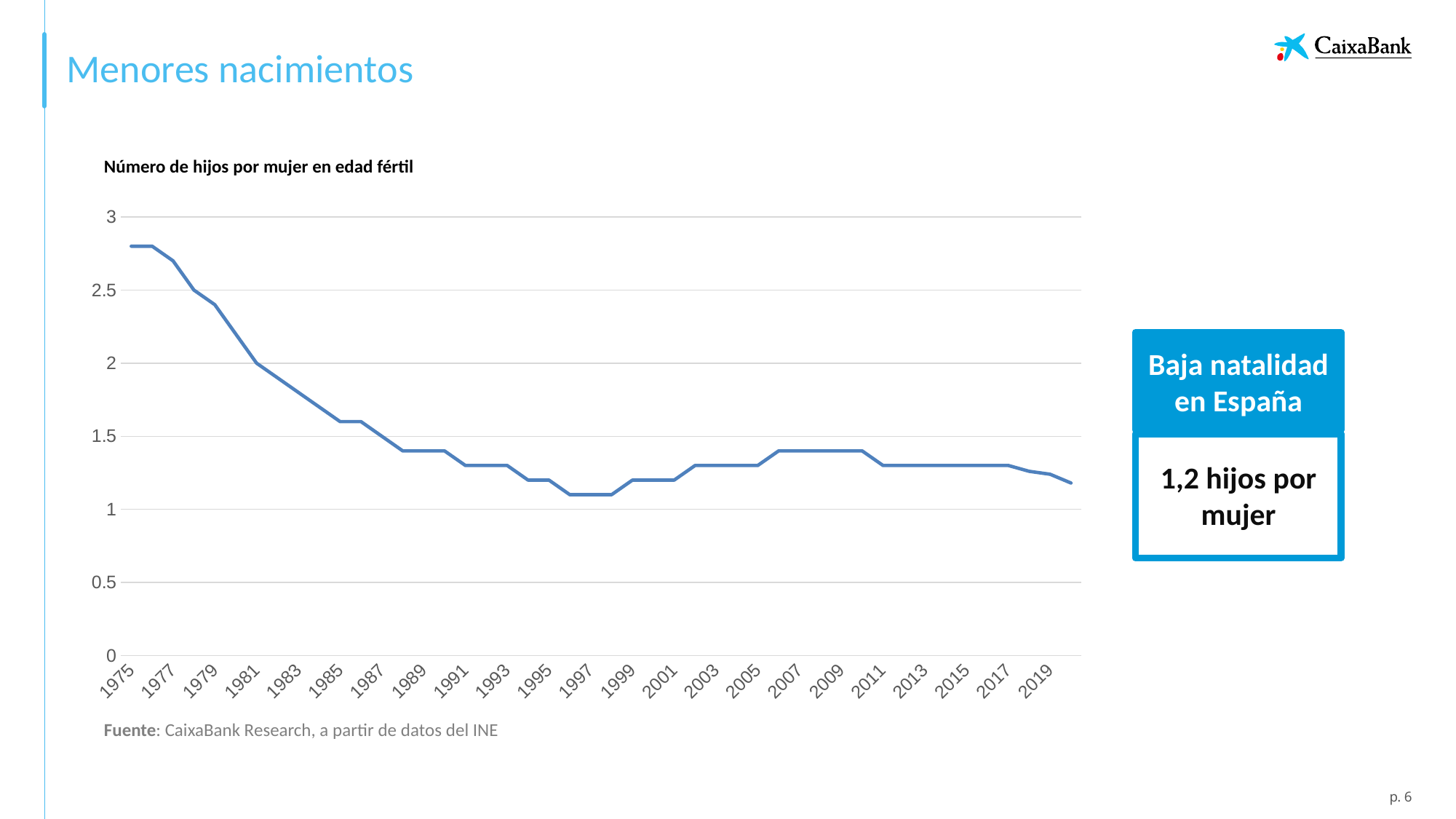
What kind of chart is shown on the slide? line chart Overall, do the values rise or fall from 1975 to 2019? fall Which year has the larger value, 1975 or 2019? 1975 Is the value for 2019 greater or less than 1.5? less Is the value for 1985 greater or less than 1.5? greater How many lines are plotted on the chart? 1 Is the value for 1997 greater or less than 1.5? less According to the source note, where does the chart's data come from? CaixaBank Research, a partir de datos del INE Which year has the larger value, 1997 or 2007? 2007 What is the title of the chart? Número de hijos por mujer en edad fértil